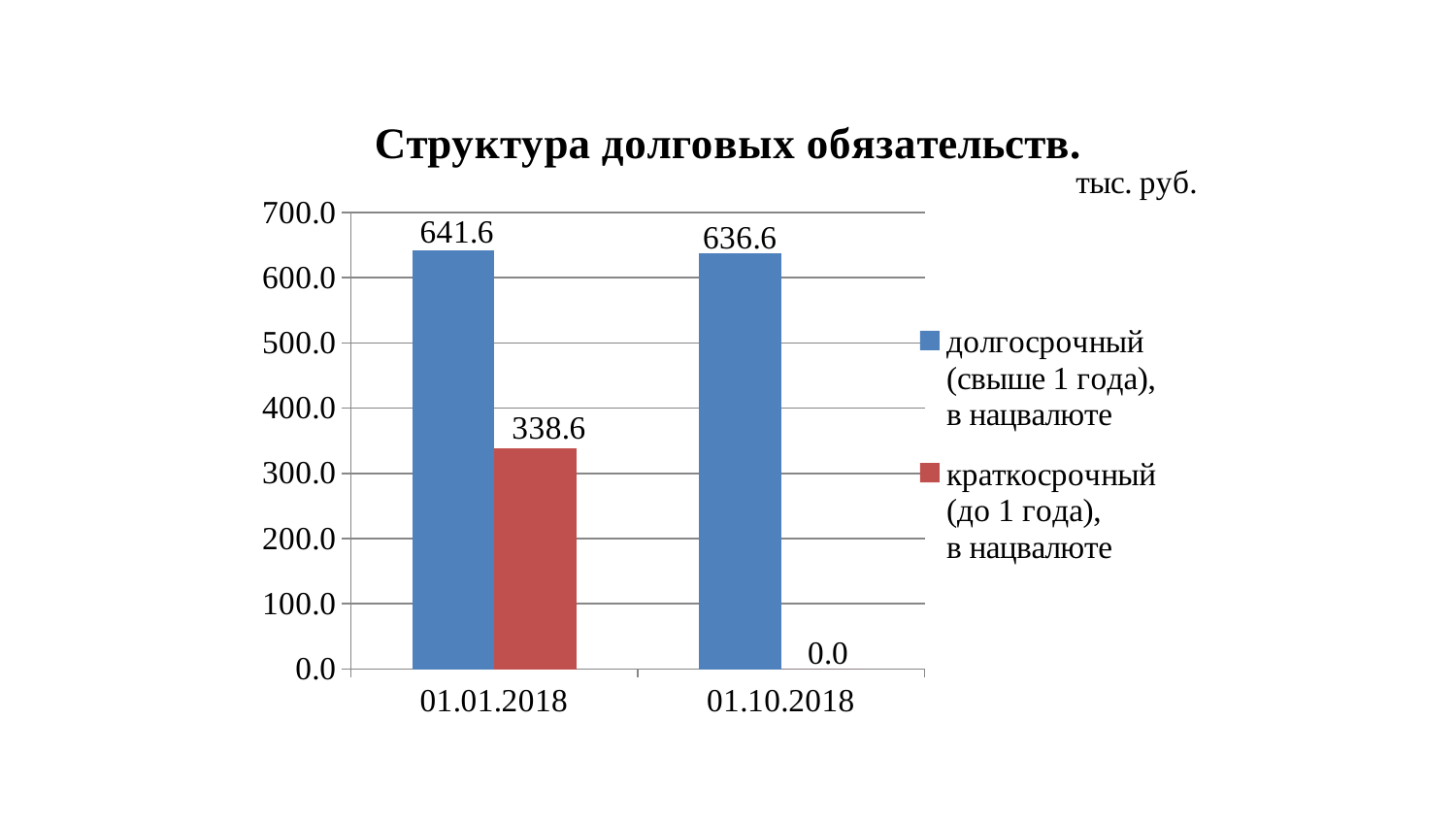
Is the краткосрочный value for 01.01.2018 greater or less than 400.0? less What is the value of долгосрочный (свыше 1 года), в нацвалюте for 01.10.2018? 636.6 How many series does the legend list? 2 How many dates are shown on the x axis? 2 What is the difference between the долгосрочный and краткосрочный values for 01.01.2018? 303.0 What is the value of долгосрочный (свыше 1 года), в нацвалюте for 01.01.2018? 641.6 What is the value of краткосрочный (до 1 года), в нацвалюте for 01.10.2018? 0.0 What kind of chart is shown on the slide? bar chart Which is larger for 01.01.2018: долгосрочный or краткосрочный? долгосрочный What is the title of the chart? Структура долговых обязательств. What is the difference between the долгосрочный values for 01.01.2018 and 01.10.2018? 5.0 What is the value of краткосрочный (до 1 года), в нацвалюте for 01.01.2018? 338.6